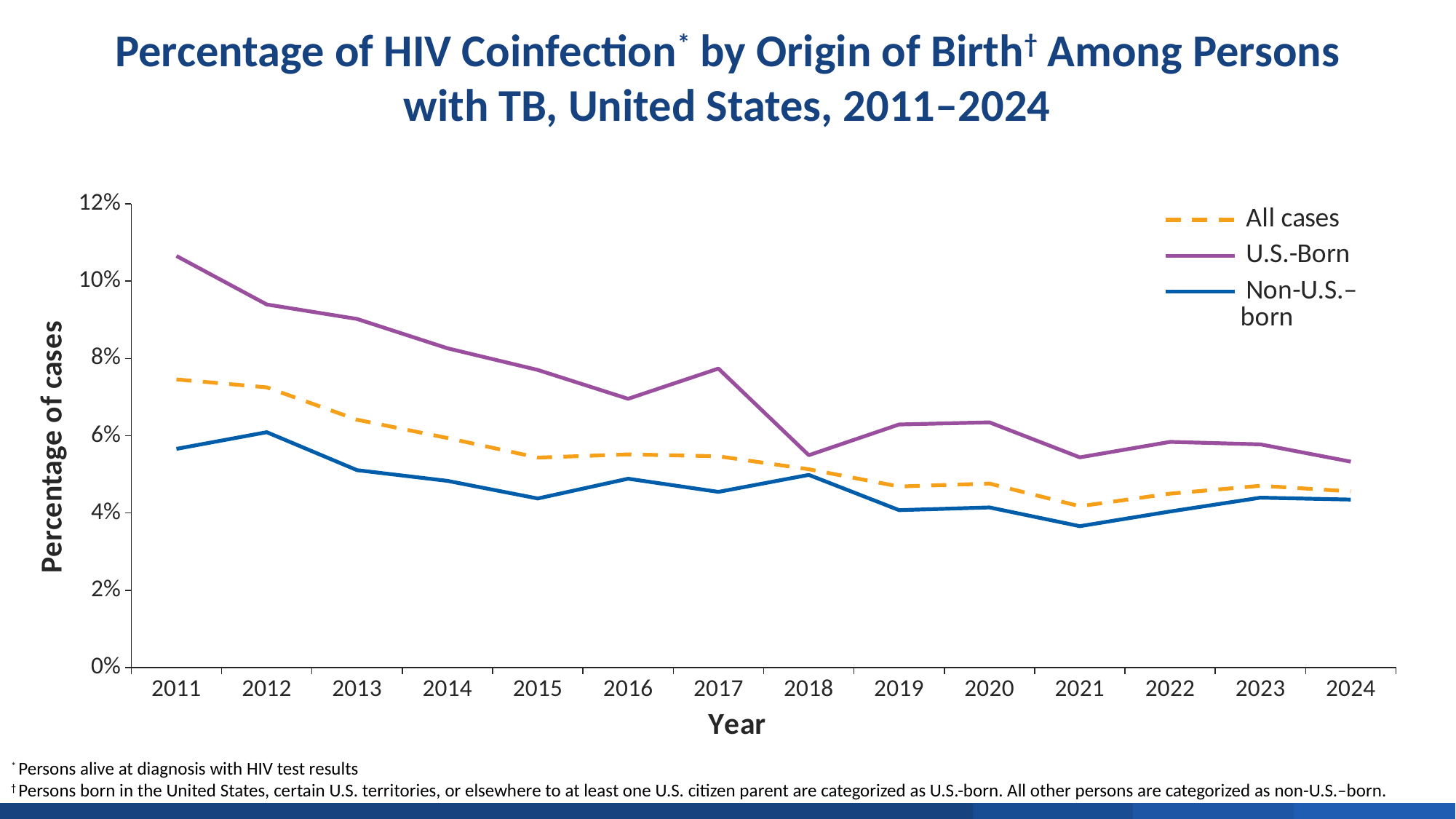
In which year is the U.S.-Born percentage highest? 2011 Is the U.S.-Born value for 2011 greater or less than 10%? greater In which year is the Non-U.S.-born percentage lowest? 2021 What kind of chart is shown on the slide? line chart Is the Non-U.S.-born value for 2021 greater or less than 4%? less Is the All cases value for 2011 greater or less than 8%? less In 2024, which series has the highest percentage of cases? U.S.-Born Which legend entry is drawn as a dashed line? All cases How many series does the legend list? 3 How many years are plotted along the x axis? 14 In 2011, which is larger: the U.S.-Born value or the All cases value? U.S.-Born Does the U.S.-Born line rise or fall overall from 2011 to 2024? fall